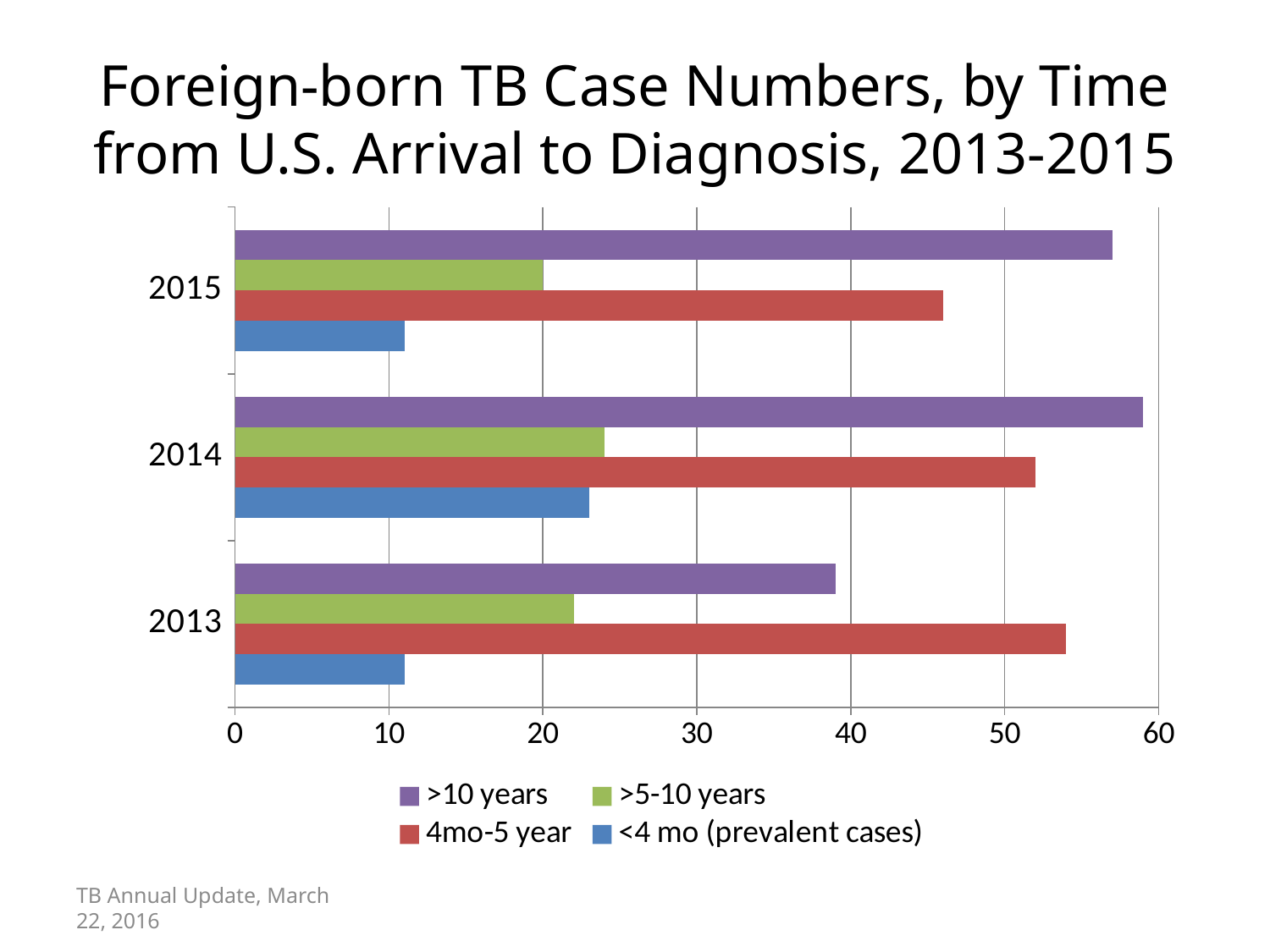
Is the value for 4mo-5 year in 2014 greater or less than 40? greater In 2015, which series has the highest value? >10 years Is the value for >10 years in 2015 greater or less than 50? greater In 2014, which series has the lowest value? <4 mo (prevalent cases) Is the value for <4 mo (prevalent cases) in 2013 greater or less than 20? less Does the value for 4mo-5 year rise or fall from 2013 to 2015? fall What kind of chart is shown on the slide? Bar chart Which is larger: <4 mo (prevalent cases) in 2014 or <4 mo (prevalent cases) in 2015? 2014 How many years are shown on the vertical axis? 3 How many series does the legend list? 4 In 2013, which is larger: 4mo-5 year or >10 years? 4mo-5 year